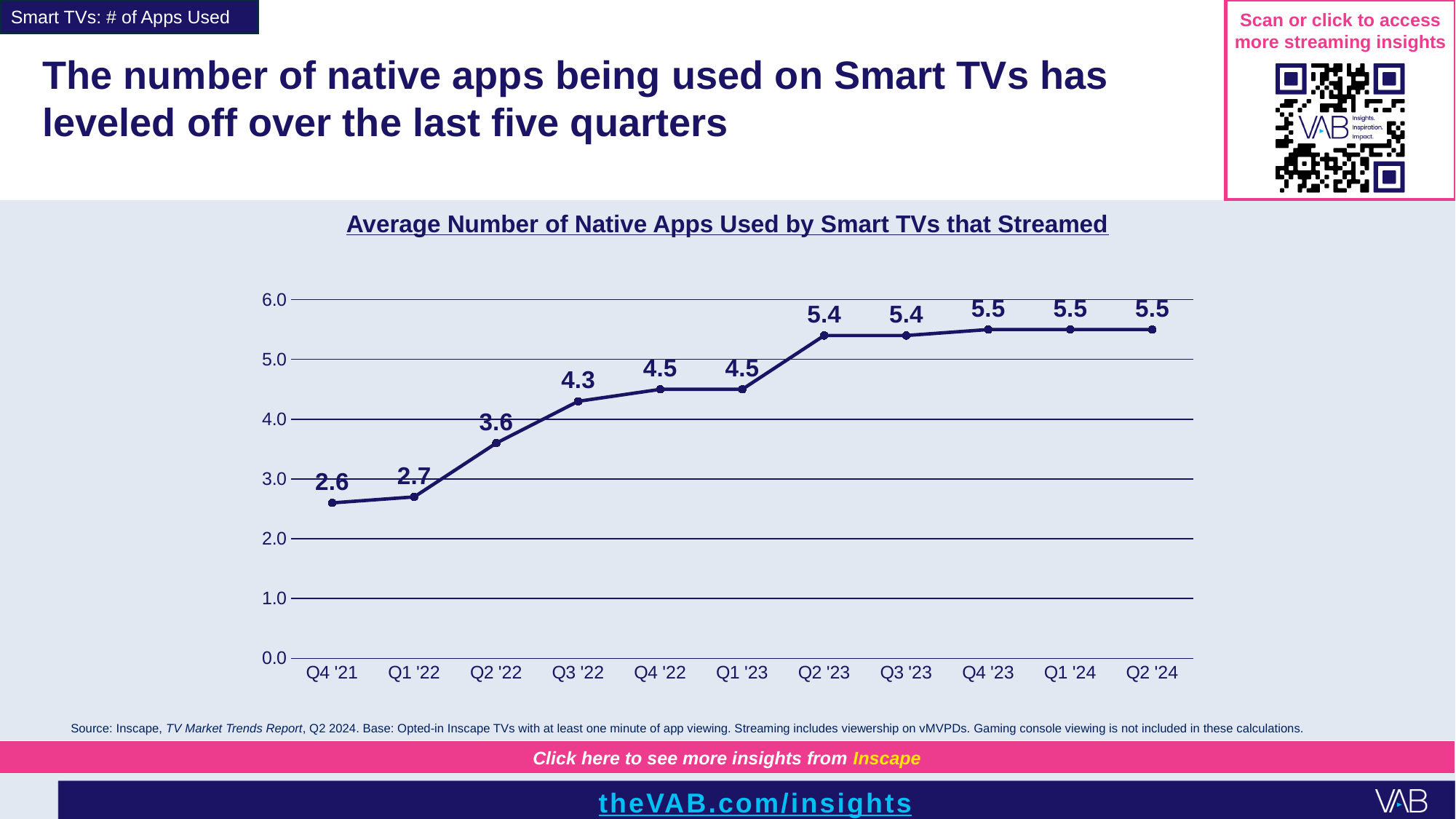
How many quarters are plotted on the chart? 11 What is the average number of native apps used in Q2 '24? 5.5 What is the average number of native apps used in Q3 '22? 4.3 What is the difference between the values for Q2 '24 and Q4 '21? 2.9 Which quarter has the lowest average number of native apps used? Q4 '21 What is the difference between the values for Q2 '23 and Q2 '22? 1.8 What is the title of the chart? Average Number of Native Apps Used by Smart TVs that Streamed Which is larger, the value for Q1 '22 or the value for Q2 '22? Q2 '22 Is the value for Q4 '22 greater or less than 4.0? greater What kind of chart is shown on the slide? Line chart What is the average number of native apps used in Q4 '21? 2.6 Do the values generally rise or fall from Q4 '21 to Q2 '24? Rise